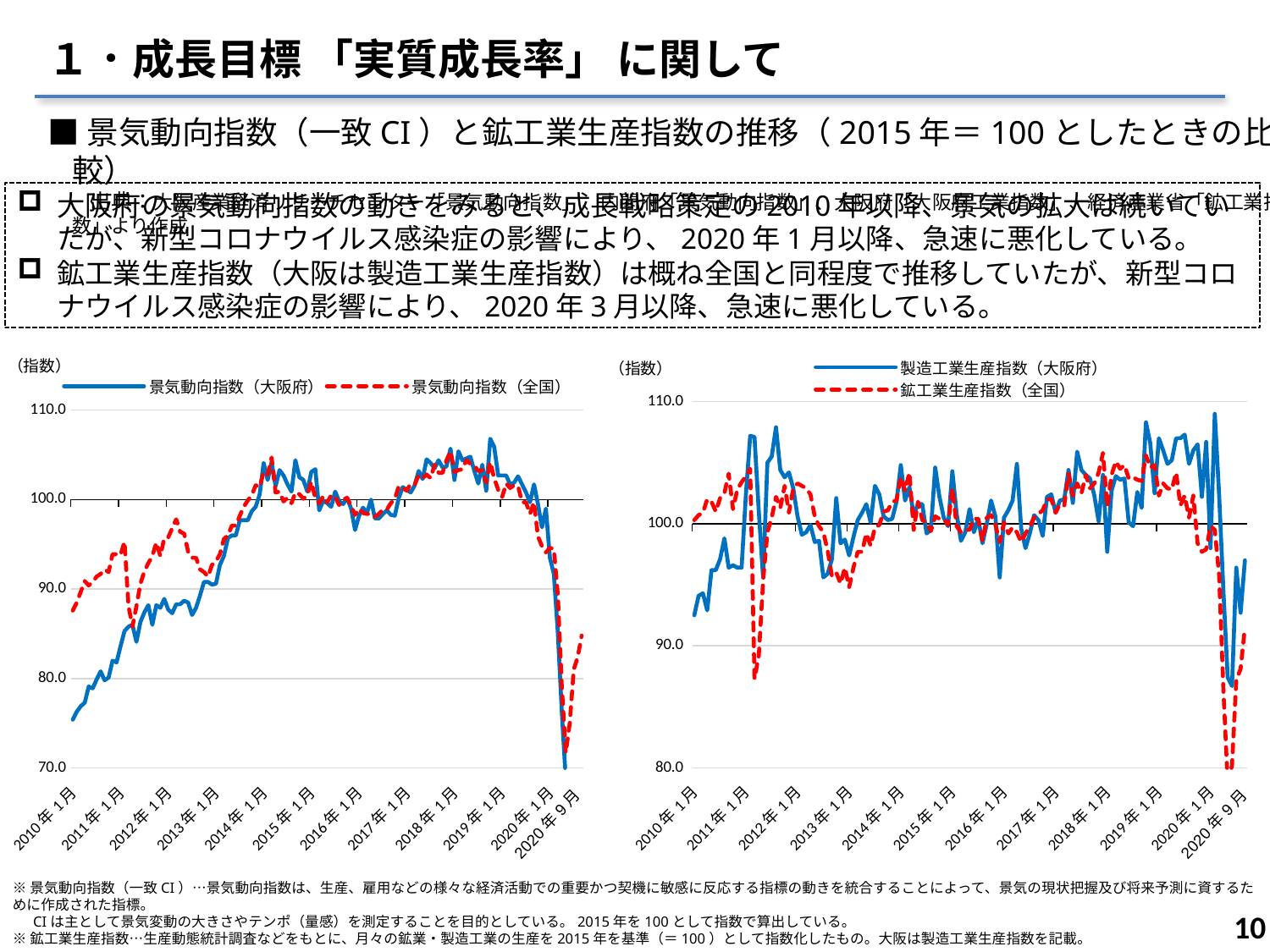
In the left chart, is the value of 景気動向指数（全国） at 2010年1月 greater or less than 90? less In the left chart, at 2010年1月, which series has the higher value: 景気動向指数（大阪府） or 景気動向指数（全国）? 景気動向指数（全国） How many series does the legend of the right chart list? 2 In the left chart, is the value of 景気動向指数（大阪府） at 2010年1月 greater or less than 80? less In the left chart, does 景気動向指数（大阪府） rise or fall between 2010年1月 and 2014年1月? rise What kind of chart is the right chart (製造工業生産指数 / 鉱工業生産指数)? line chart What kind of chart is the left chart (景気動向指数)? line chart In the right chart, which series is drawn as a solid blue line? 製造工業生産指数（大阪府） In the left chart, which series is drawn as a red dashed line? 景気動向指数（全国） In the right chart, does 製造工業生産指数（大阪府） rise or fall between 2019年1月 and 2020年1月 onward into 2020? fall In the right chart, is the value of 製造工業生産指数（大阪府） at 2010年1月 greater or less than 100? less How many series does the legend of the left chart list? 2